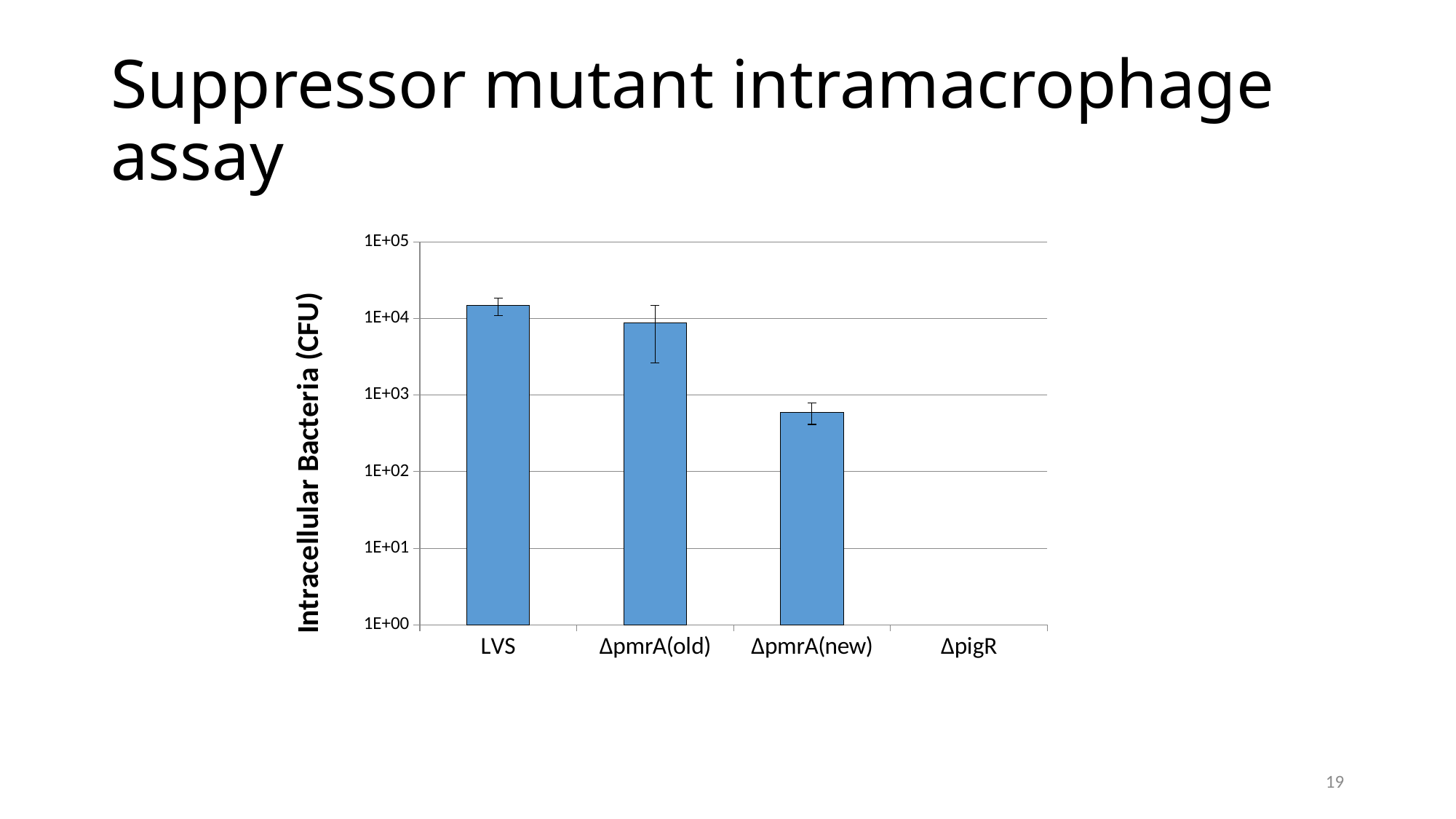
Which is larger, the value for LVS or the value for ΔpmrA(new)? LVS Is the value for LVS greater or less than 1E+04? greater Which is larger, the value for ΔpmrA(old) or the value for ΔpmrA(new)? ΔpmrA(old) How many categories are shown on the x axis of the chart? 4 Do the bar values rise or fall from left to right across the x axis? fall What kind of chart is shown on the slide? bar chart Is the value for ΔpmrA(new) greater or less than 1E+03? less Which of the three visible bars is the lowest? ΔpmrA(new) Is the value for ΔpmrA(new) greater or less than 1E+02? greater Which category has no visible bar in the chart? ΔpigR Which category has the highest intracellular bacteria value? LVS What is the title of the y axis? Intracellular Bacteria (CFU)